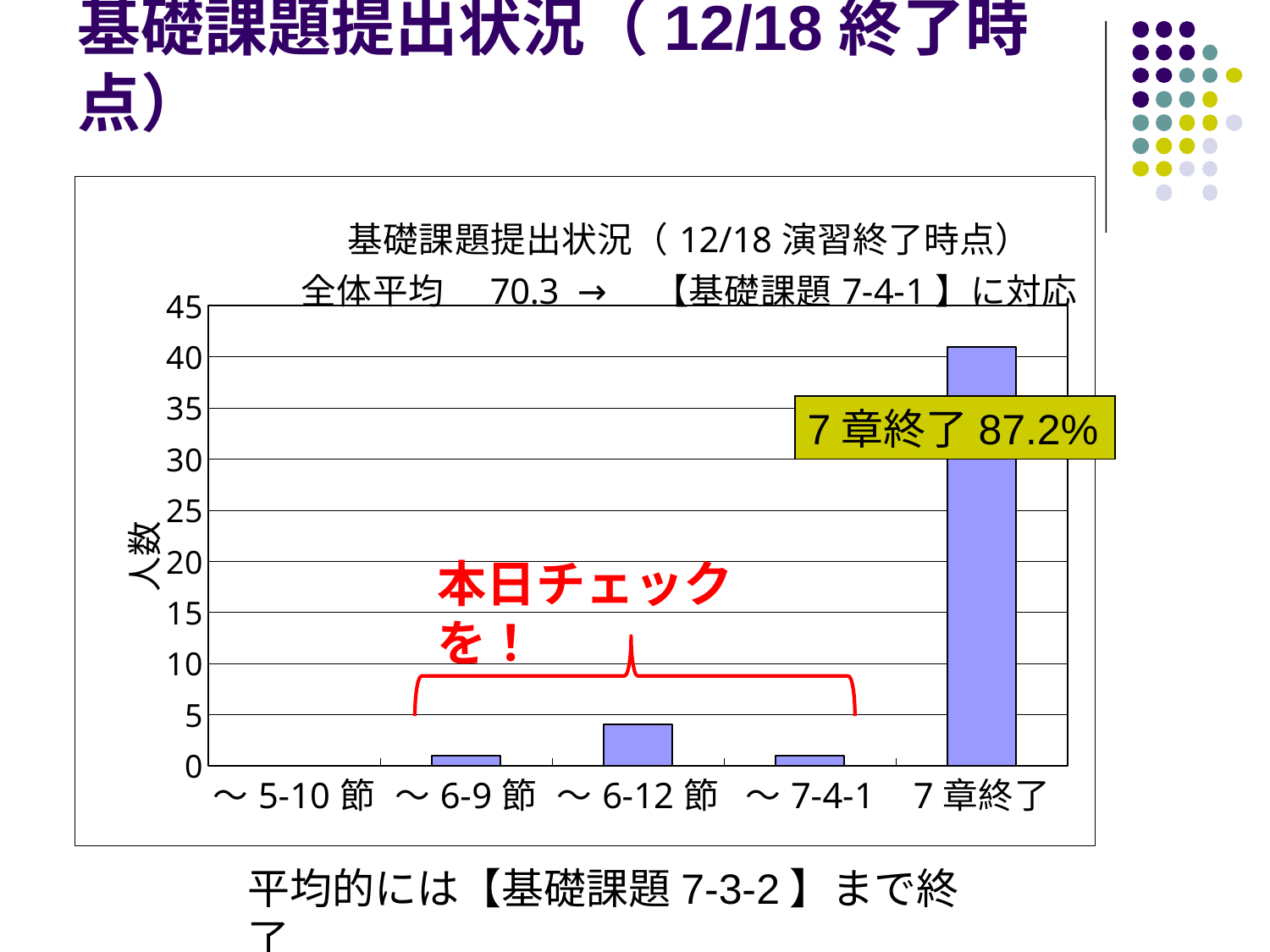
Which category has the lowest value (no visible bar) in the chart? ～ 5-10 節 Which is larger, the value for ～ 6-12 節 or the value for ～ 6-9 節? ～ 6-12 節 Is the value for ～ 6-9 節 greater or less than 5? less Which category has the highest bar in the chart? 7 章終了 Which is larger, the value for 7 章終了 or the value for ～ 7-4-1? 7 章終了 How many categories are shown on the x axis of the chart? 5 What is the label of the y axis of the chart? 人数 What percentage is shown in the highlighted box next to the tallest bar? 87.2% Is the value for 7 章終了 greater or less than 35? greater What kind of chart is shown on the slide? bar chart Is the value for ～ 6-12 節 greater or less than 5? less